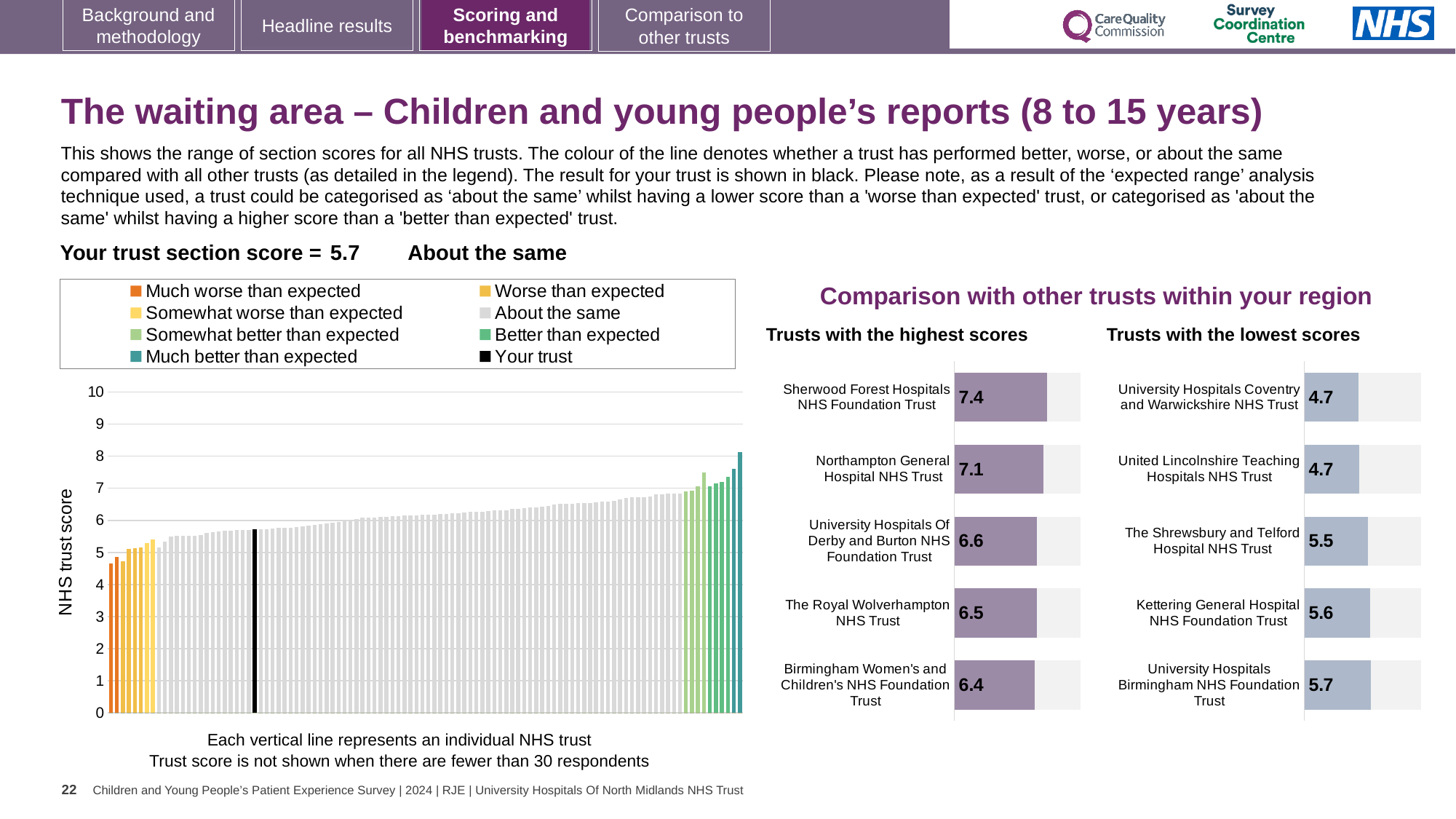
In the 'Trusts with the lowest scores' chart, which trust has the highest score? University Hospitals Birmingham NHS Foundation Trust In the 'Trusts with the lowest scores' chart, what is the score for The Shrewsbury and Telford Hospital NHS Trust? 5.5 In the 'Trusts with the highest scores' chart, what is the score for Sherwood Forest Hospitals NHS Foundation Trust? 7.4 In the main chart on the left, do the bar values rise or fall from left to right? rise In the 'Trusts with the highest scores' chart, what is the difference between the scores of Sherwood Forest Hospitals NHS Foundation Trust and Birmingham Women's and Children's NHS Foundation Trust? 1.0 In the 'Trusts with the highest scores' chart, which has the larger score: Northampton General Hospital NHS Trust or University Hospitals Of Derby and Burton NHS Foundation Trust? Northampton General Hospital NHS Trust In the 'Trusts with the highest scores' chart, what is the score for The Royal Wolverhampton NHS Trust? 6.5 In the 'Trusts with the highest scores' chart, which trust has the lowest score? Birmingham Women's and Children's NHS Foundation Trust In the 'Trusts with the lowest scores' chart, what is the difference between the scores of The Shrewsbury and Telford Hospital NHS Trust and University Hospitals Coventry and Warwickshire NHS Trust? 0.8 In the main chart on the left, is the value of the lowest (leftmost) bar greater or less than 5? less How many trusts are listed in the 'Trusts with the lowest scores' chart? 5 In the 'Trusts with the highest scores' chart, which trust has the highest score? Sherwood Forest Hospitals NHS Foundation Trust